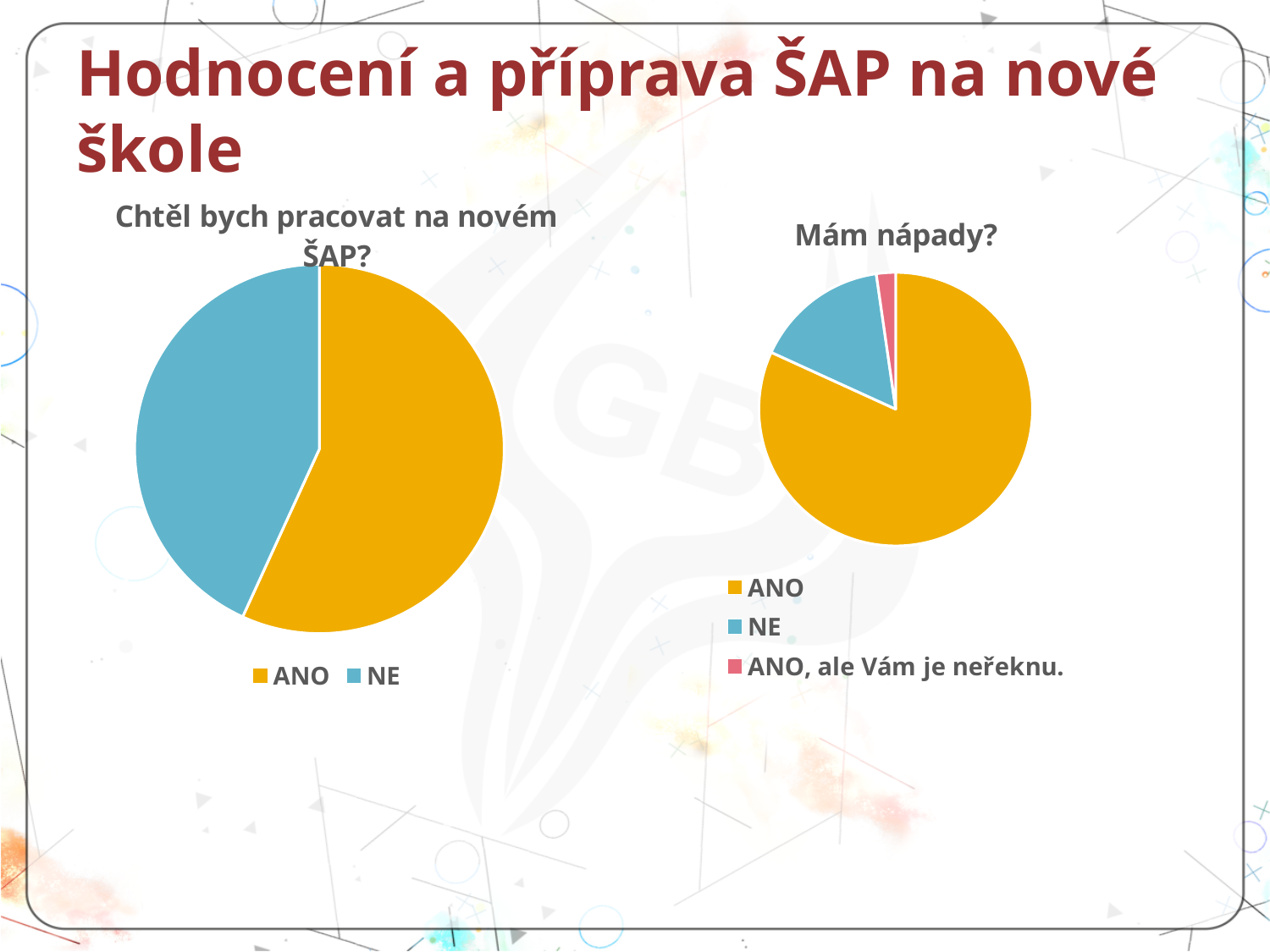
What kind of chart is the chart titled "Chtěl bych pracovat na novém ŠAP?"? pie chart In the chart titled "Chtěl bych pracovat na novém ŠAP?", which category has the largest slice? ANO What kind of chart is the chart titled "Mám nápady?"? pie chart In the chart titled "Mám nápady?", how many entries does the legend list? 3 In the chart titled "Mám nápady?", which category has the smallest slice? ANO, ale Vám je neřeknu. In the chart titled "Mám nápady?", what colour is the slice for "ANO, ale Vám je neřeknu."? red In the chart titled "Mám nápady?", how many slices does the pie have? 3 In the chart titled "Mám nápady?", which slice is larger, NE or "ANO, ale Vám je neřeknu."? NE In the chart titled "Chtěl bych pracovat na novém ŠAP?", how many slices does the pie have? 2 In the chart titled "Chtěl bych pracovat na novém ŠAP?", which slice is larger, ANO or NE? ANO In the chart titled "Mám nápady?", which category has the largest slice? ANO In the chart titled "Chtěl bych pracovat na novém ŠAP?", which category has the smallest slice? NE